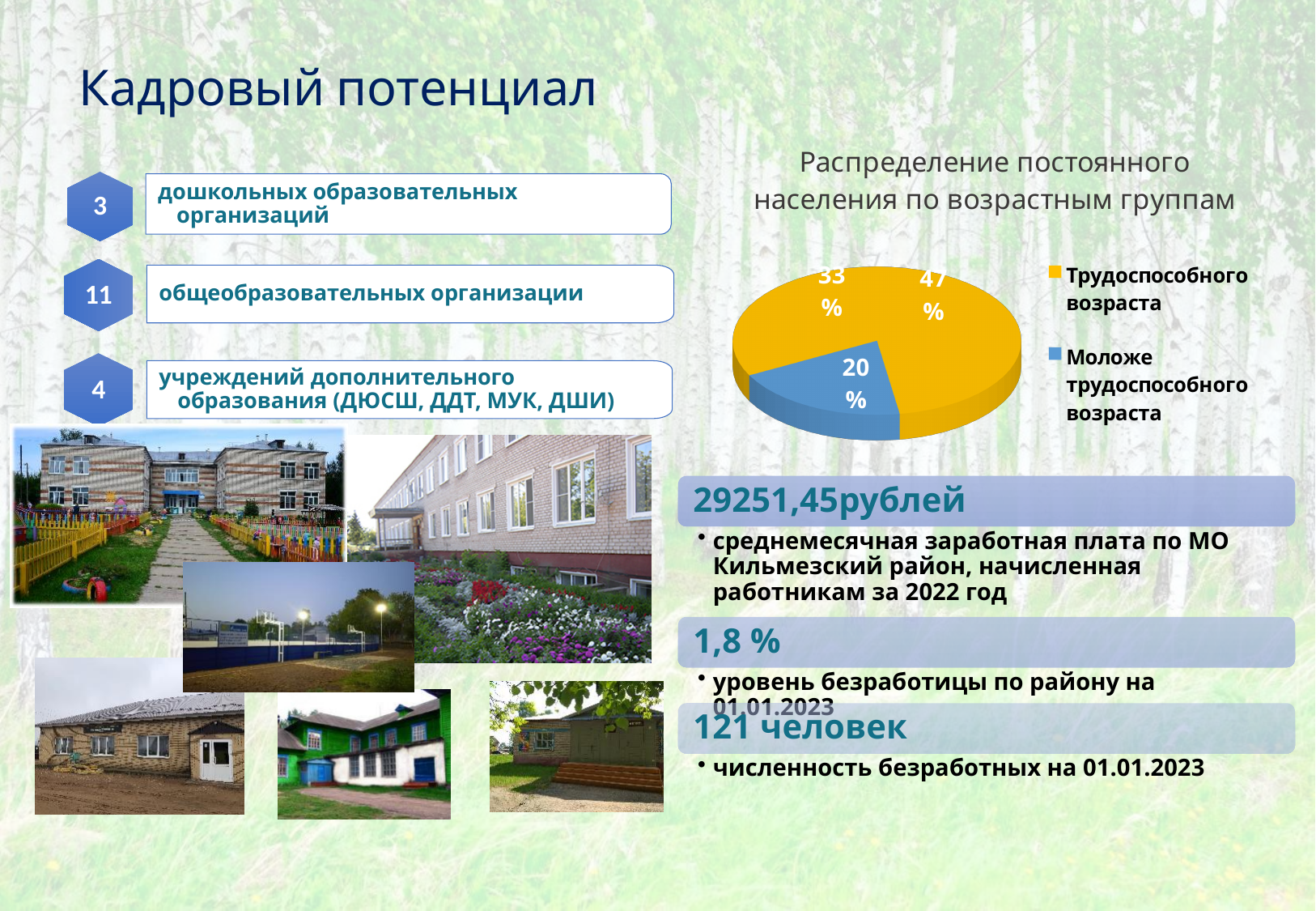
How many entries does the legend of the pie chart list? 2 What kind of chart is shown on the slide? pie chart Which slice is larger in the pie chart: "Трудоспособного возраста" or "Моложе трудоспособного возраста"? Трудоспособного возраста What share of the pie is labelled for "Моложе трудоспособного возраста"? 20% What colour is the "Моложе трудоспособного возраста" slice in the pie chart? blue What is the title of the pie chart? Распределение постоянного населения по возрастным группам Which legend category has the smallest slice in the pie chart? Моложе трудоспособного возраста